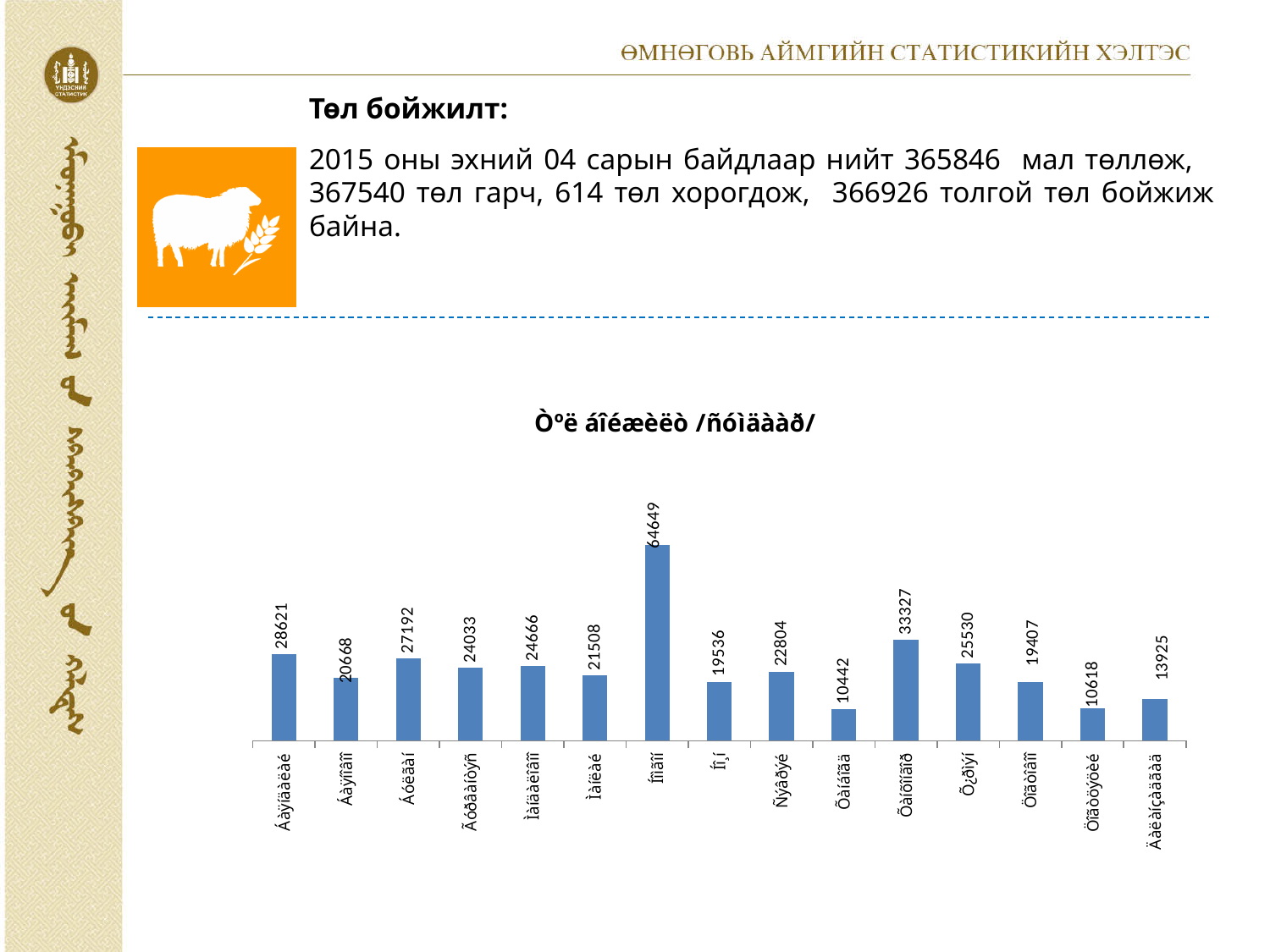
What is the difference between the first bar (28621) and the second bar (20668)? 7953 What is the difference between the highest and lowest values in the chart? 54207 Which is larger, the first bar from the left or the third bar from the left? the first bar (28621) What colour are the bars in the chart? blue What is the highest value shown in the chart? 64649 What is the value of the rightmost bar in the chart? 13925 What is the value of the leftmost bar in the chart? 28621 How many bars does the chart contain? 15 What is the value of the eleventh bar from the left, the second tallest? 33327 What kind of chart is shown on the slide? bar chart What is the value of the seventh bar from the left, the tallest one? 64649 What is the lowest value shown in the chart? 10442